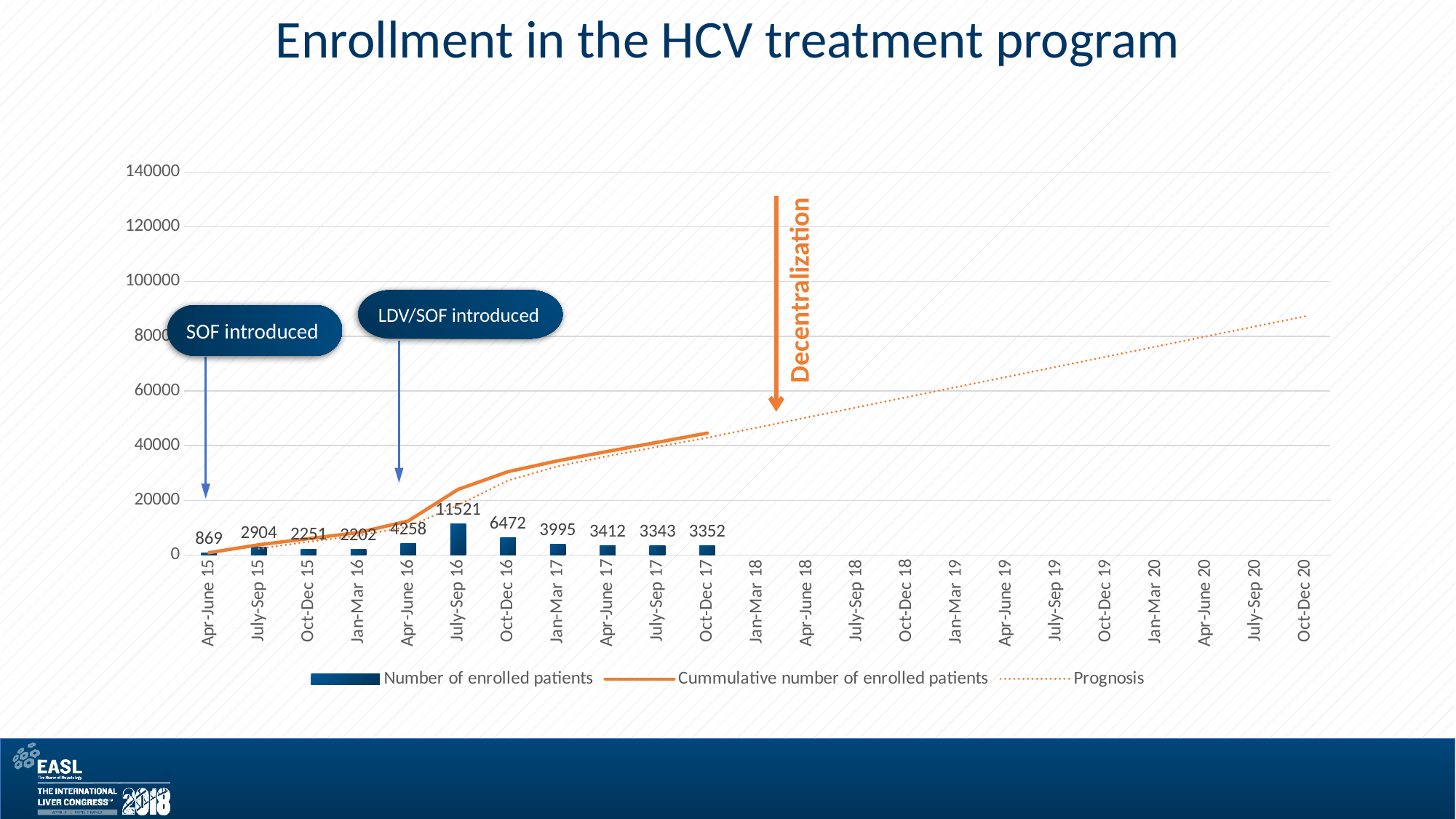
Which quarter has the lowest number of enrolled patients? Apr-June 15 Is the prognosis value at Oct-Dec 20 greater or less than 80000? greater How many series does the legend list? 3 Is the cumulative number of enrolled patients at Oct-Dec 17 greater or less than 40000? greater What is the difference in enrolled patients between July-Sep 16 and Oct-Dec 16? 5049 Which quarter had more enrolled patients, Oct-Dec 16 or Jan-Mar 17? Oct-Dec 16 Does the cumulative number of enrolled patients rise or fall over time? rise What is the number of enrolled patients for Oct-Dec 17? 3352 How many quarters have a bar for the number of enrolled patients? 11 Which quarter has the highest number of enrolled patients? July-Sep 16 What is the number of enrolled patients for Apr-June 15? 869 How many patients were enrolled in July-Sep 16? 11521